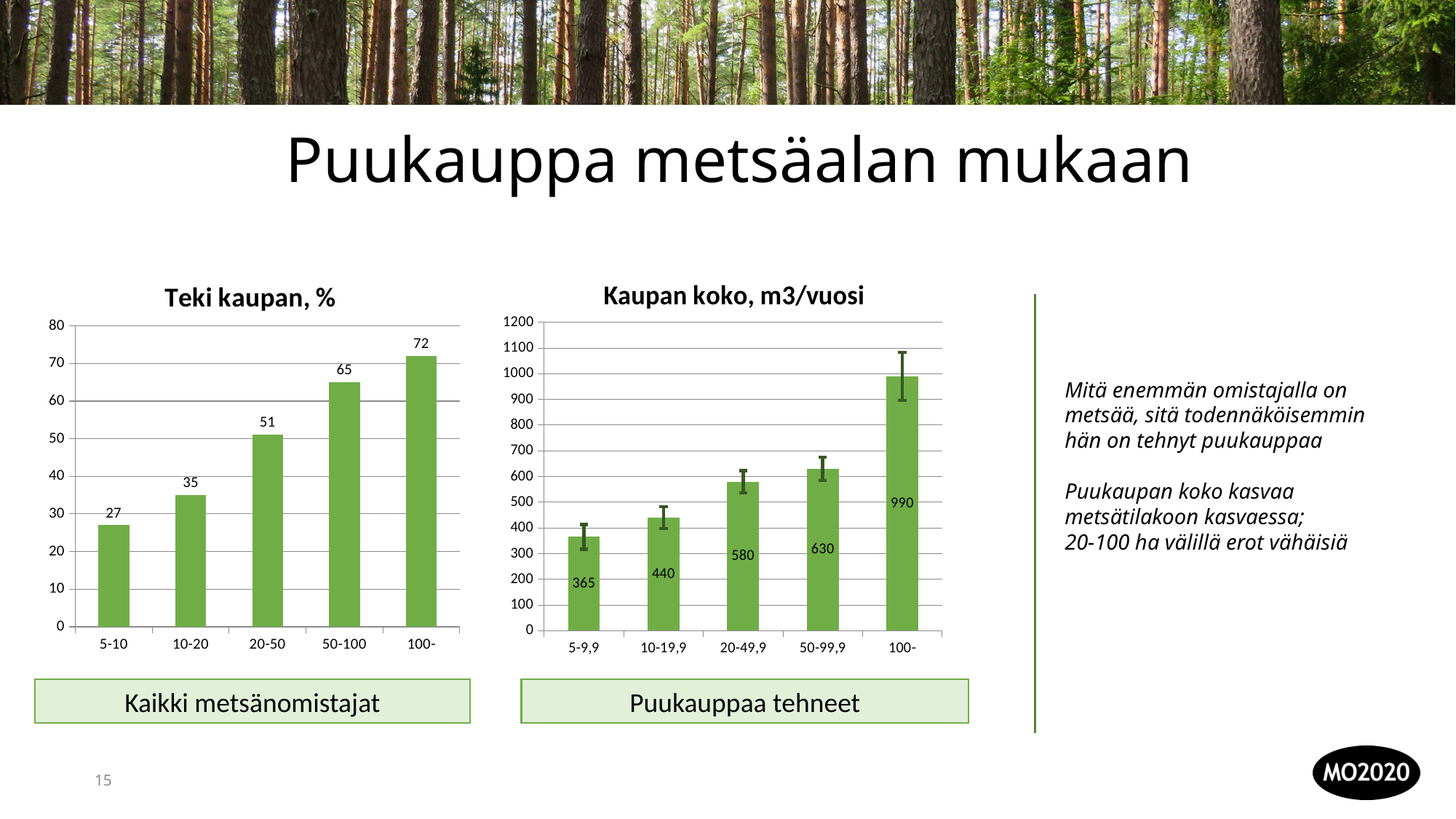
In the 'Kaupan koko, m3/vuosi' chart, what is the value for the 100- category? 990 In the 'Teki kaupan, %' chart, which category has the highest value? 100- In the 'Teki kaupan, %' chart, what is the difference between the values for 50-100 and 20-50? 14 In the 'Teki kaupan, %' chart, how many categories are shown on the x axis? 5 In the 'Kaupan koko, m3/vuosi' chart, what is the difference between the values for 100- and 50-99,9? 360 In the 'Teki kaupan, %' chart, do the values rise or fall from left to right along the x axis? rise In the 'Kaupan koko, m3/vuosi' chart, what is the value for the 20-49,9 category? 580 In the 'Kaupan koko, m3/vuosi' chart, which category has the lowest value? 5-9,9 In the 'Kaupan koko, m3/vuosi' chart, which is larger, the value for 10-19,9 or the value for 20-49,9? 20-49,9 In the 'Teki kaupan, %' chart, which category has the lowest value? 5-10 In the 'Teki kaupan, %' chart, what is the value for the 5-10 category? 27 What kind of chart is the 'Kaupan koko, m3/vuosi' chart? bar chart